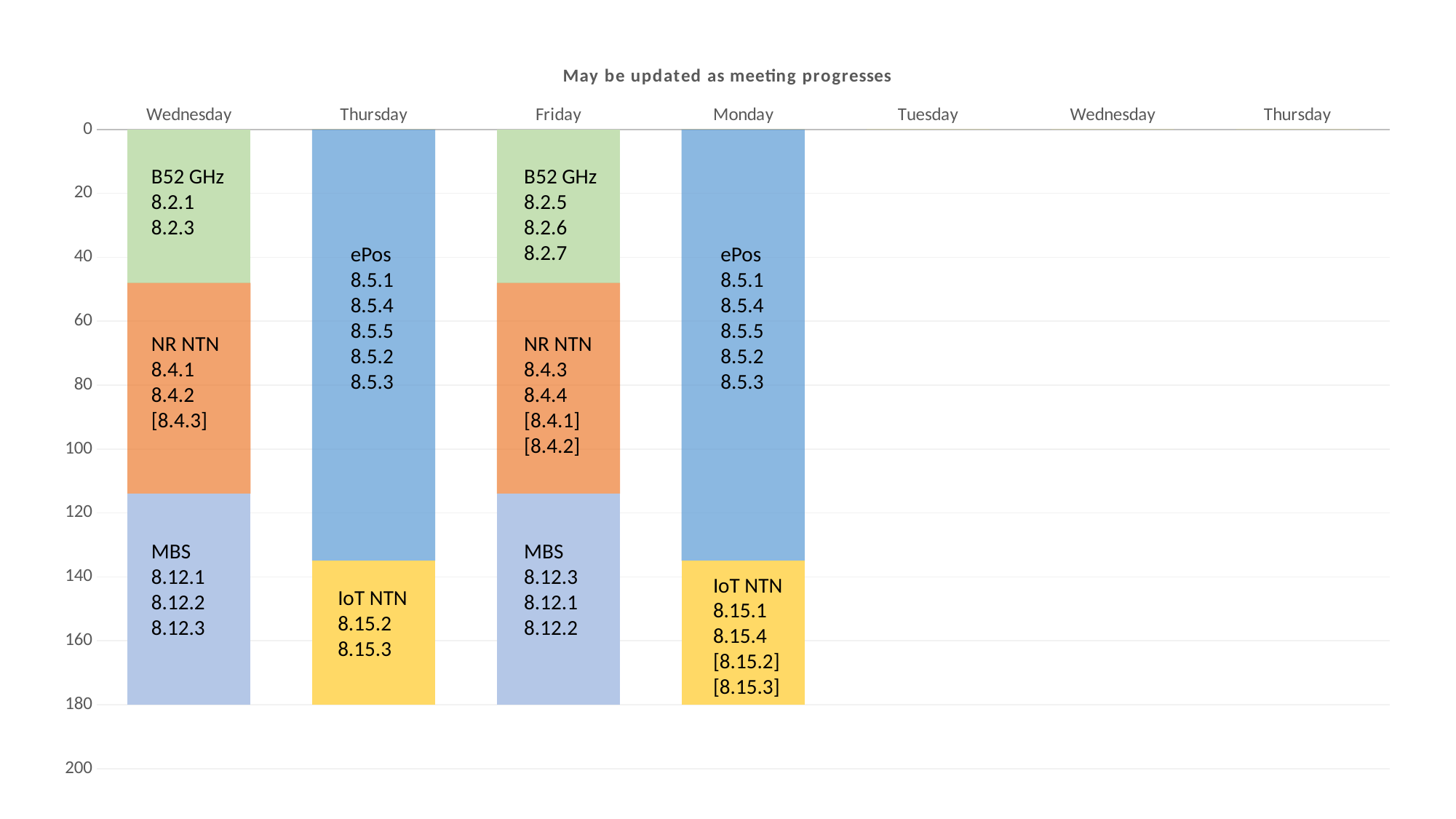
Which topic occupies the bottom (yellow) segment of the Thursday bar? IoT NTN What kind of chart is shown on the slide? Stacked bar chart How many of the day columns contain a plotted bar? 4 Which topic occupies the top (green) segment of the Wednesday bar? B52 GHz What is the title text shown above the chart? May be updated as meeting progresses At what axis value does the Wednesday bar end? 180 Which agenda items are listed in the IoT NTN segment of the Monday bar? 8.15.1, 8.15.4, [8.15.2], [8.15.3] Is the size of the ePos segment on Monday greater or less than 120? greater Is the size of the B52 GHz segment on Friday greater or less than 60? less Is the ePos segment of the Thursday bar larger or smaller than the IoT NTN segment of the same bar? larger How many day labels are shown along the top axis of the chart? 7 Which agenda items are listed in the MBS segment of the Friday bar? 8.12.3, 8.12.1, 8.12.2